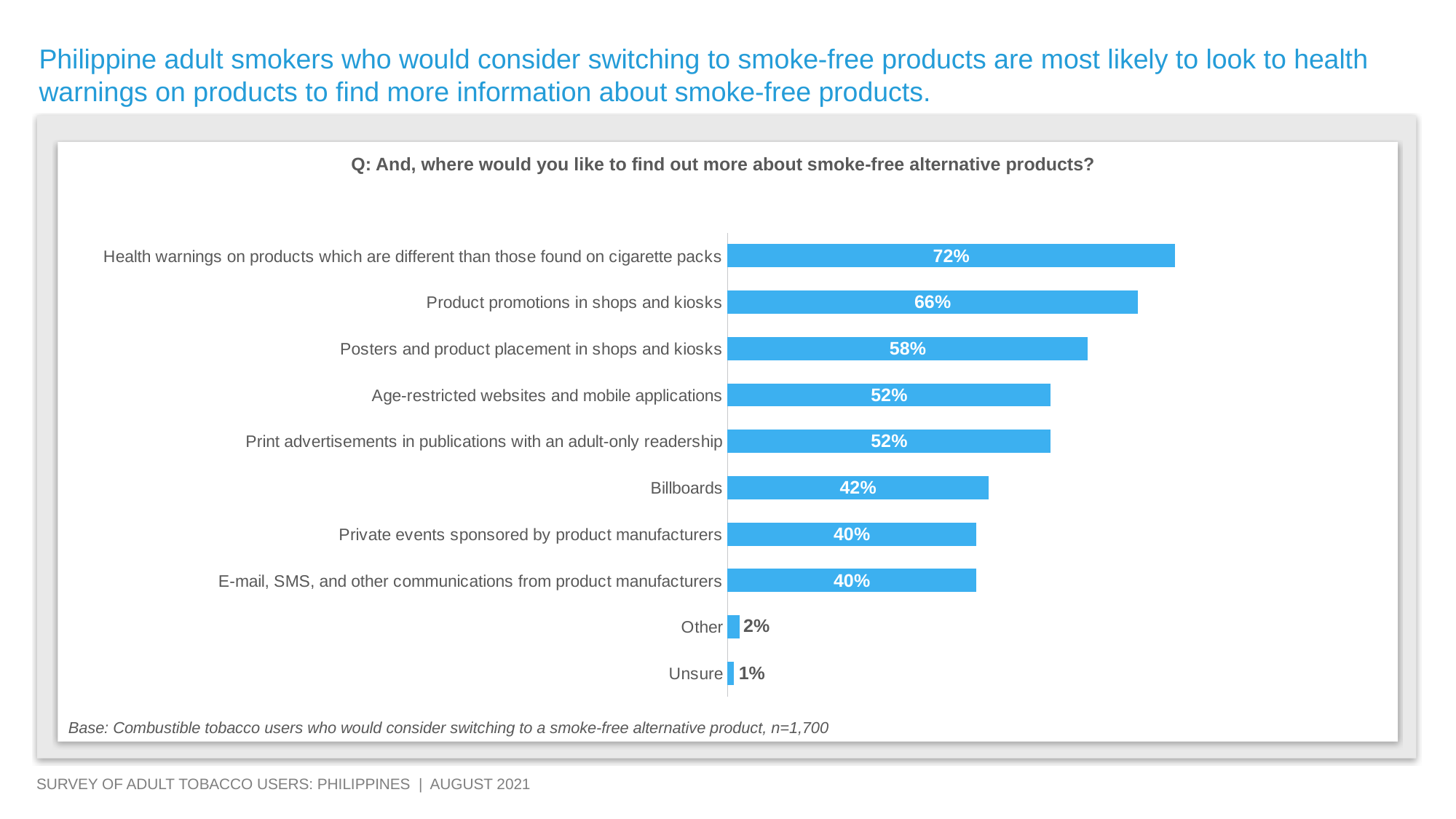
What is the value for "Billboards"? 42% What is the difference between the values for "Health warnings on products which are different than those found on cigarette packs" and "Product promotions in shops and kiosks"? 6% Which is larger: the value for "Billboards" or the value for "Private events sponsored by product manufacturers"? Billboards What is the value for "Age-restricted websites and mobile applications"? 52% What is the base size (n) stated below the chart? n=1,700 How many categories are shown in the chart? 10 What kind of chart is shown on the slide? Bar chart What percentage of respondents chose "Product promotions in shops and kiosks"? 66% Which category has the highest value? Health warnings on products which are different than those found on cigarette packs What is the difference between "Posters and product placement in shops and kiosks" and "Billboards"? 16% Which category has the lowest value? Unsure What percentage is shown for "Unsure"? 1%